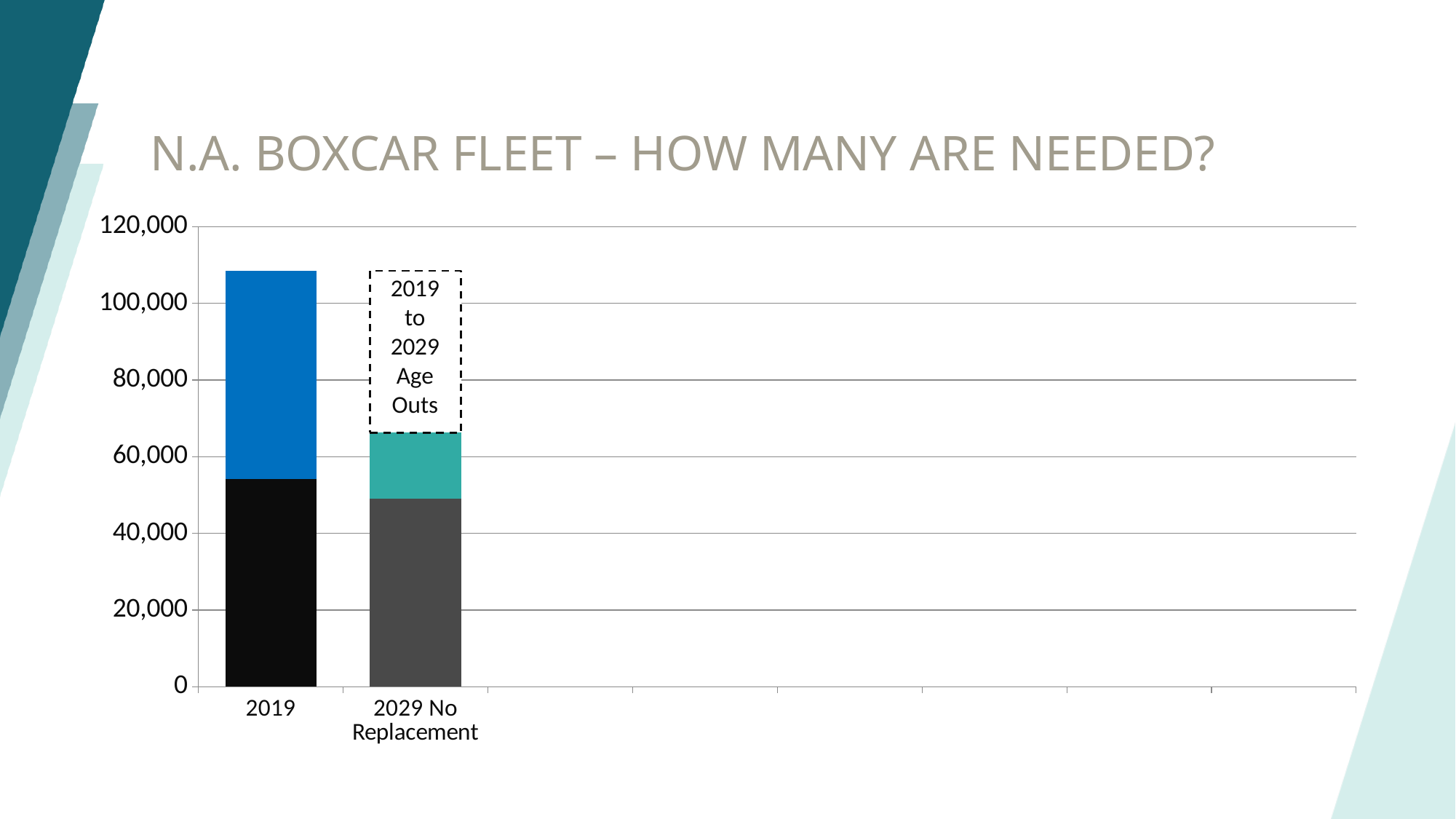
What kind of chart is shown on the slide? bar chart What does the dashed box above the 2029 No Replacement bar say? 2019 to 2029 Age Outs Is the bottom (grey) segment of the 2029 No Replacement bar greater or less than 40,000? greater What is the title of the slide containing the chart? N.A. BOXCAR FLEET – HOW MANY ARE NEEDED? How many categories are shown on the x axis of the chart? 2 Is the total value for 2029 No Replacement greater or less than 60,000? greater Is the bottom (black) segment of the 2019 bar greater or less than 60,000? less